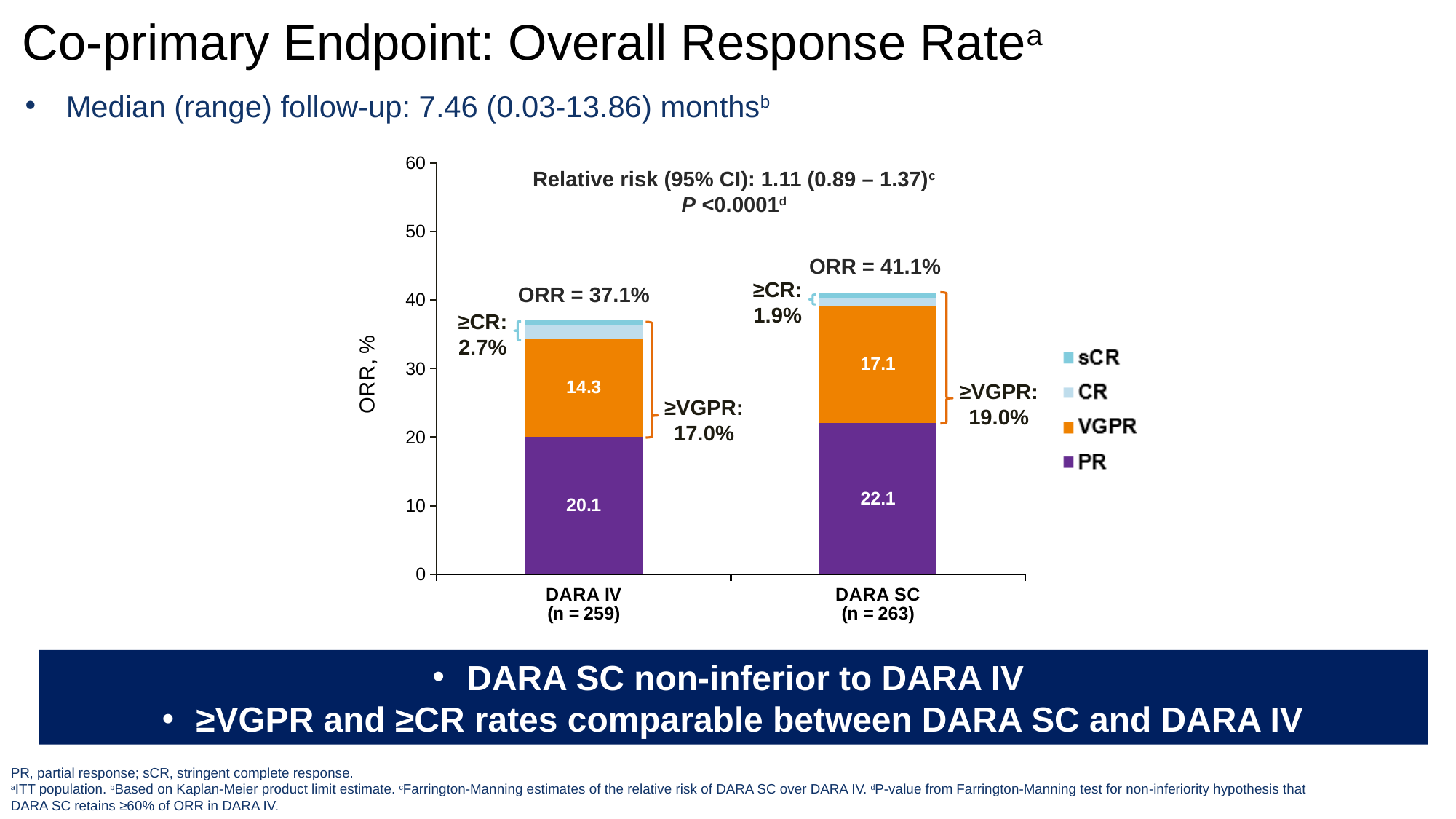
What is the PR value for DARA IV? 20.1 Which group has the higher ORR, DARA IV or DARA SC? DARA SC How many series does the legend list? 4 Which group has the larger PR value, DARA IV or DARA SC? DARA SC What is the VGPR value for DARA SC? 17.1 What is the difference between the PR values for DARA SC and DARA IV? 2.0 What type of chart is shown? Stacked bar chart What is the difference between the VGPR values for DARA SC and DARA IV? 2.8 Is the total height of the DARA SC bar greater or less than 40? greater What is the ≥CR rate for DARA IV? 2.7% What is the ORR for DARA SC? 41.1% What is the total ORR of the DARA IV stacked bar? 37.1%